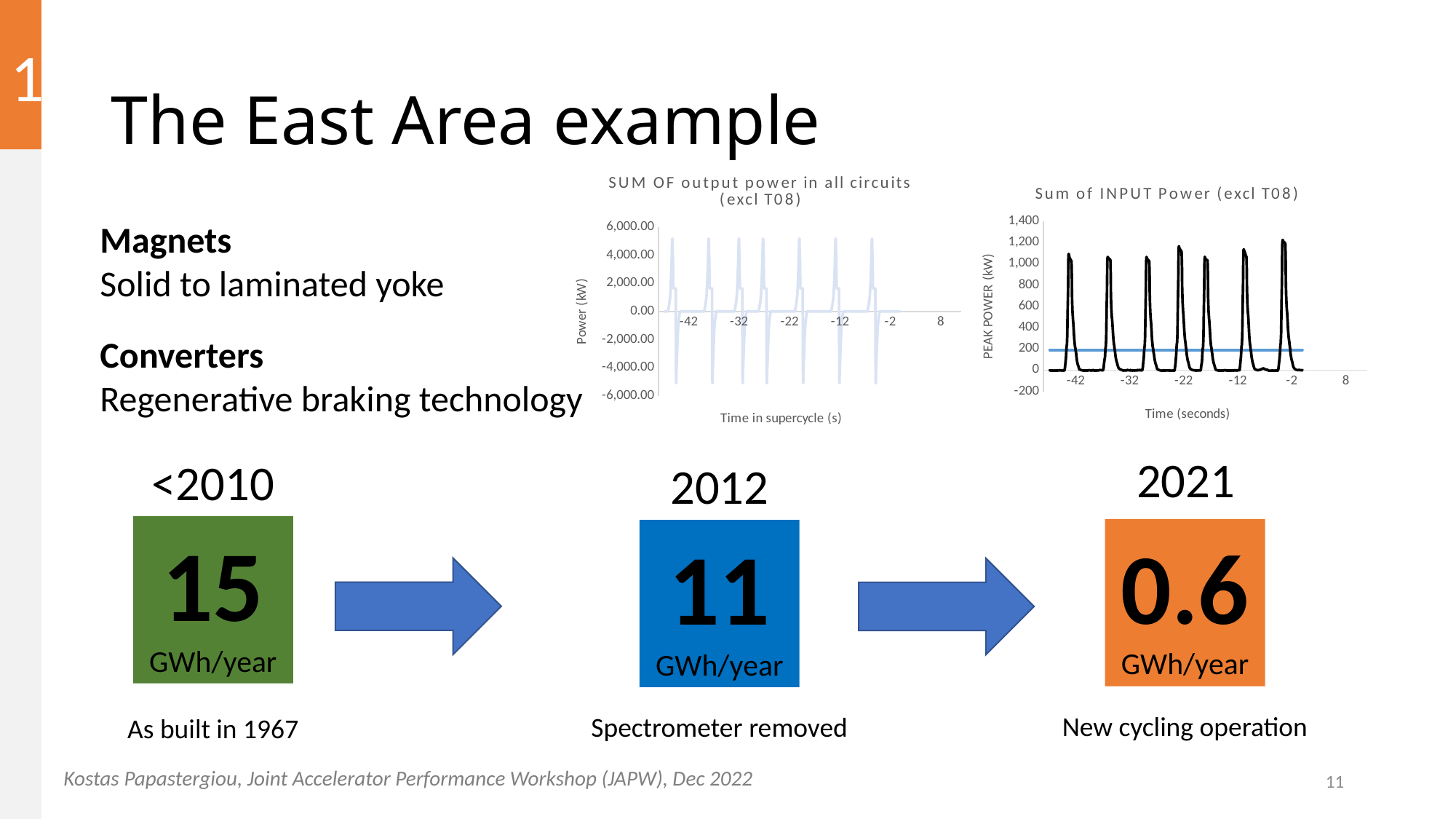
How many peaks does the black line show in the 'Sum of INPUT Power (excl T08)' chart? 7 What kind of chart is the 'Sum of INPUT Power (excl T08)' chart? line chart In the 'Sum of INPUT Power (excl T08)' chart, is the lowest y-axis tick value greater or less than 0? less In the 'Sum of INPUT Power (excl T08)' chart, is the value of the flat blue horizontal line greater or less than 0? greater In the 'SUM OF output power in all circuits (excl T08)' chart, are the negative spikes greater or less than -4,000.00? less What kind of chart is the 'SUM OF output power in all circuits (excl T08)' chart? line chart What is the x-axis label of the 'SUM OF output power in all circuits (excl T08)' chart? Time in supercycle (s) What is the y-axis label of the 'Sum of INPUT Power (excl T08)' chart? PEAK POWER (kW)